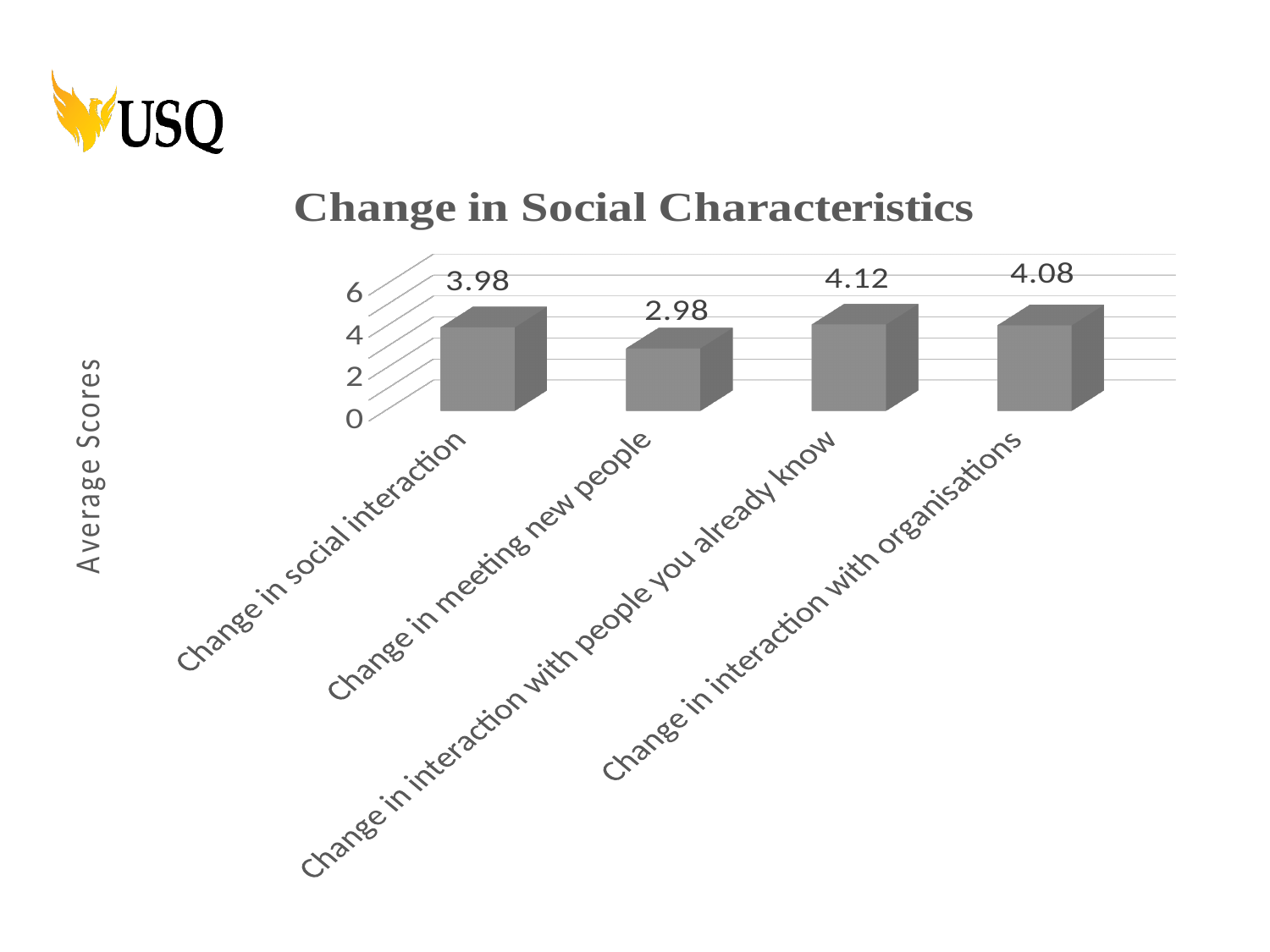
Which is larger, the value for Change in social interaction or the value for Change in meeting new people? Change in social interaction What kind of chart is shown on the slide? Bar chart What is the value for Change in social interaction? 3.98 Which category has the highest value? Change in interaction with people you already know How many categories are shown in the chart? 4 What is the label of the vertical axis? Average Scores What is the value for Change in meeting new people? 2.98 Which category has the lowest value? Change in meeting new people What is the difference between the values for Change in interaction with people you already know and Change in meeting new people? 1.14 What is the value for Change in interaction with people you already know? 4.12 What is the title of the chart? Change in Social Characteristics What is the value for Change in interaction with organisations? 4.08